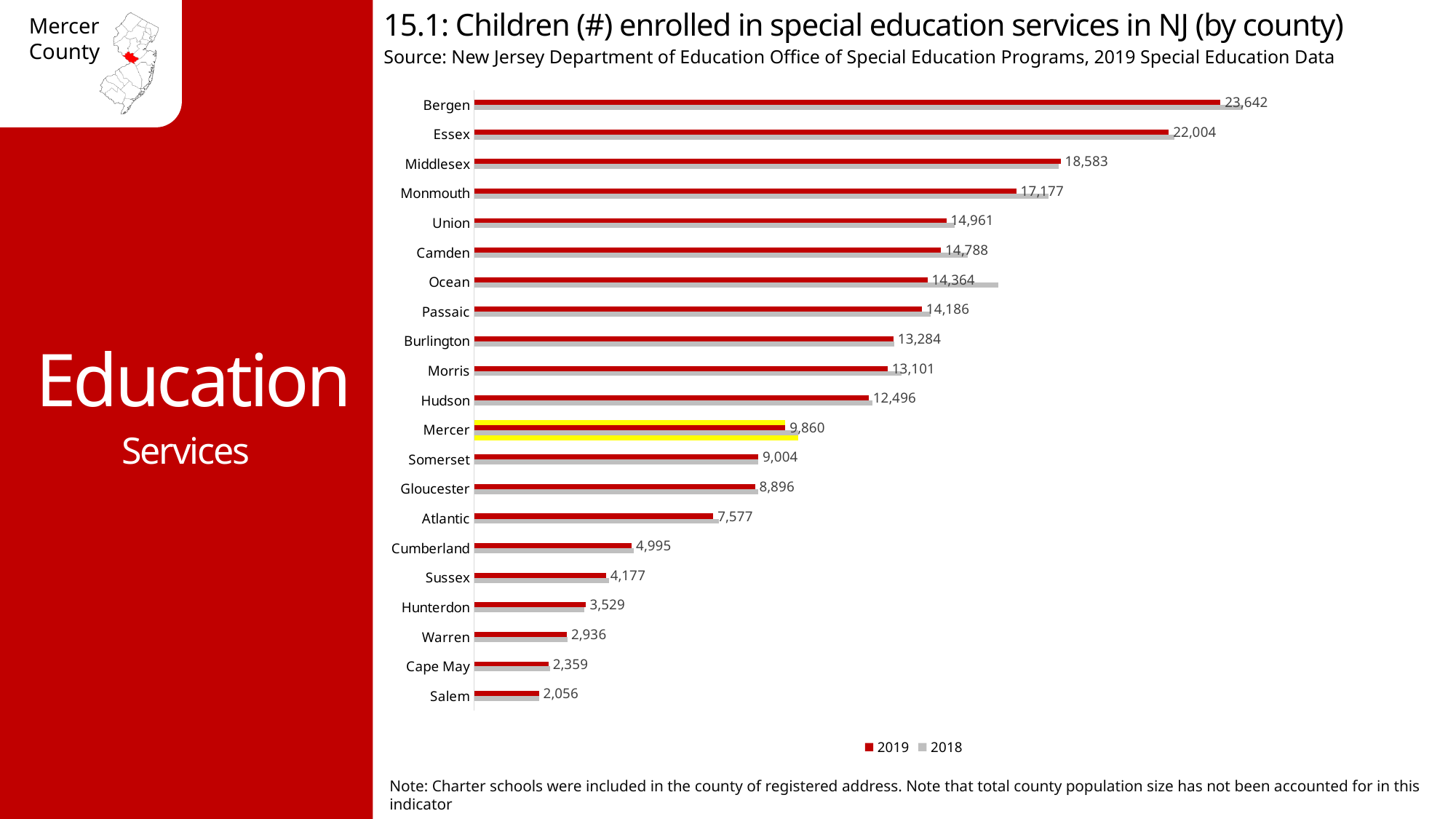
What is the difference between the 2019 values for Mercer and Somerset? 856 How many series does the legend list? 2 What is the 2019 value for Mercer? 9,860 Which county has the highest 2019 value? Bergen Which county has the lowest 2019 value? Salem What is the difference between the 2019 values for Bergen and Essex? 1,638 What kind of chart is shown on the slide? bar chart What is the 2019 value for Bergen? 23,642 For Ocean, is the 2018 bar longer or shorter than the 2019 bar? longer How many counties are shown on the chart? 21 Which county has the larger 2019 value, Camden or Ocean? Camden What is the 2019 value for Salem? 2,056